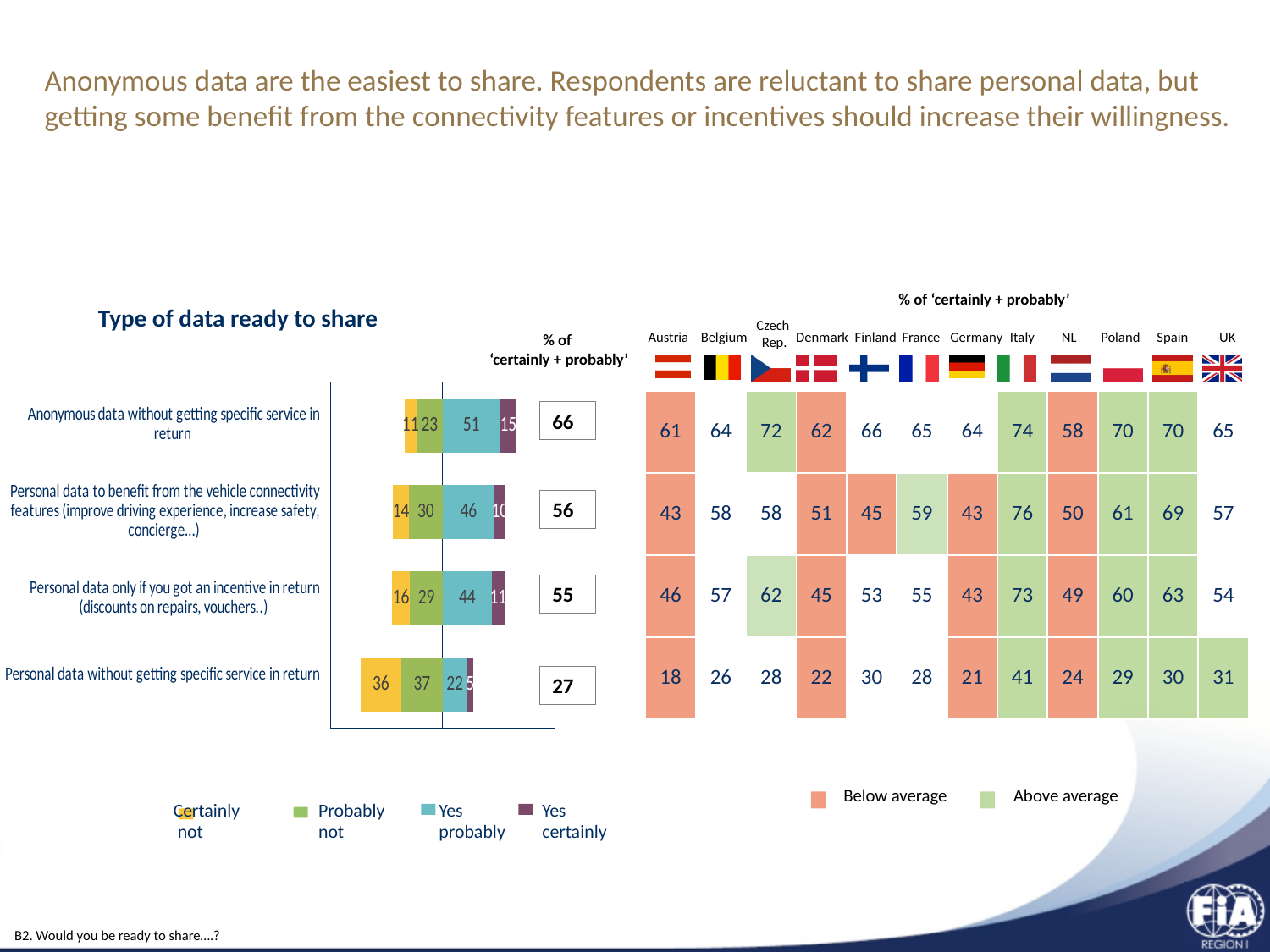
In the 'Type of data ready to share' chart, what colour represents 'Certainly not' in the legend? Yellow How many series does the legend of the 'Type of data ready to share' chart list? 4 In the 'Type of data ready to share' chart, what is the difference in '% of certainly + probably' between anonymous data without service in return and personal data without service in return? 39 In the 'Type of data ready to share' chart, what is the 'Certainly not' value for 'Personal data without getting specific service in return'? 36 In the 'Type of data ready to share' chart, is the 'Yes probably' value larger for 'Personal data to benefit from the vehicle connectivity features' or for 'Personal data only if you got an incentive in return'? Personal data to benefit from the vehicle connectivity features In the 'Type of data ready to share' chart, what is the 'Yes probably' value for 'Anonymous data without getting specific service in return'? 51 In the 'Type of data ready to share' chart, what is the '% of certainly + probably' for 'Personal data only if you got an incentive in return'? 55 How many types of data (categories) are shown in the 'Type of data ready to share' chart? 4 In the 'Type of data ready to share' chart, which type of data has the lowest '% of certainly + probably'? Personal data without getting specific service in return What kind of chart is 'Type of data ready to share'? Stacked bar chart In the country table of '% of certainly + probably', which country has the highest value for anonymous data without getting specific service in return? Italy In the 'Type of data ready to share' chart, which type of data has the highest '% of certainly + probably'? Anonymous data without getting specific service in return